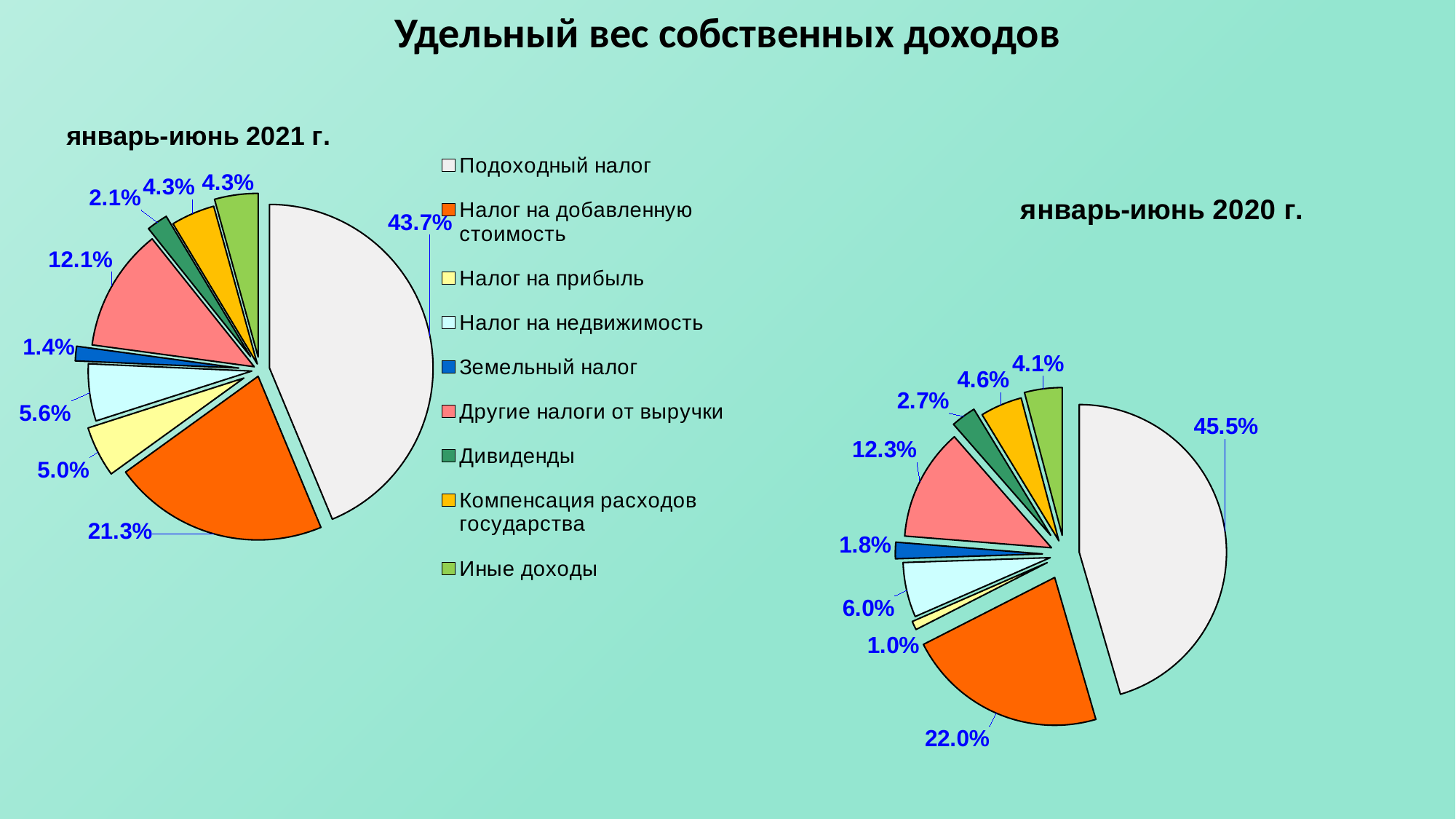
In the январь-июнь 2021 г. chart, which is larger: Налог на недвижимость or Налог на прибыль? Налог на недвижимость In the январь-июнь 2021 г. chart, what is the share of Другие налоги от выручки? 12.1% In the январь-июнь 2020 г. chart, what is the share of Дивиденды? 2.7% How many categories does the legend list? 9 In the январь-июнь 2020 г. chart, what is the share of Налог на добавленную стоимость? 22.0% What kind of charts are shown on the slide? Pie charts In the январь-июнь 2020 г. chart, which category has the largest share? Подоходный налог In the январь-июнь 2021 г. chart, what is the share of Подоходный налог? 43.7% In the январь-июнь 2021 г. chart, which category has the smallest share? Земельный налог What is the difference between the share of Подоходный налог in the январь-июнь 2020 г. chart and in the январь-июнь 2021 г. chart? 1.8% What is the title of the slide? Удельный вес собственных доходов In the январь-июнь 2020 г. chart, what is the share of Налог на прибыль? 1.0%